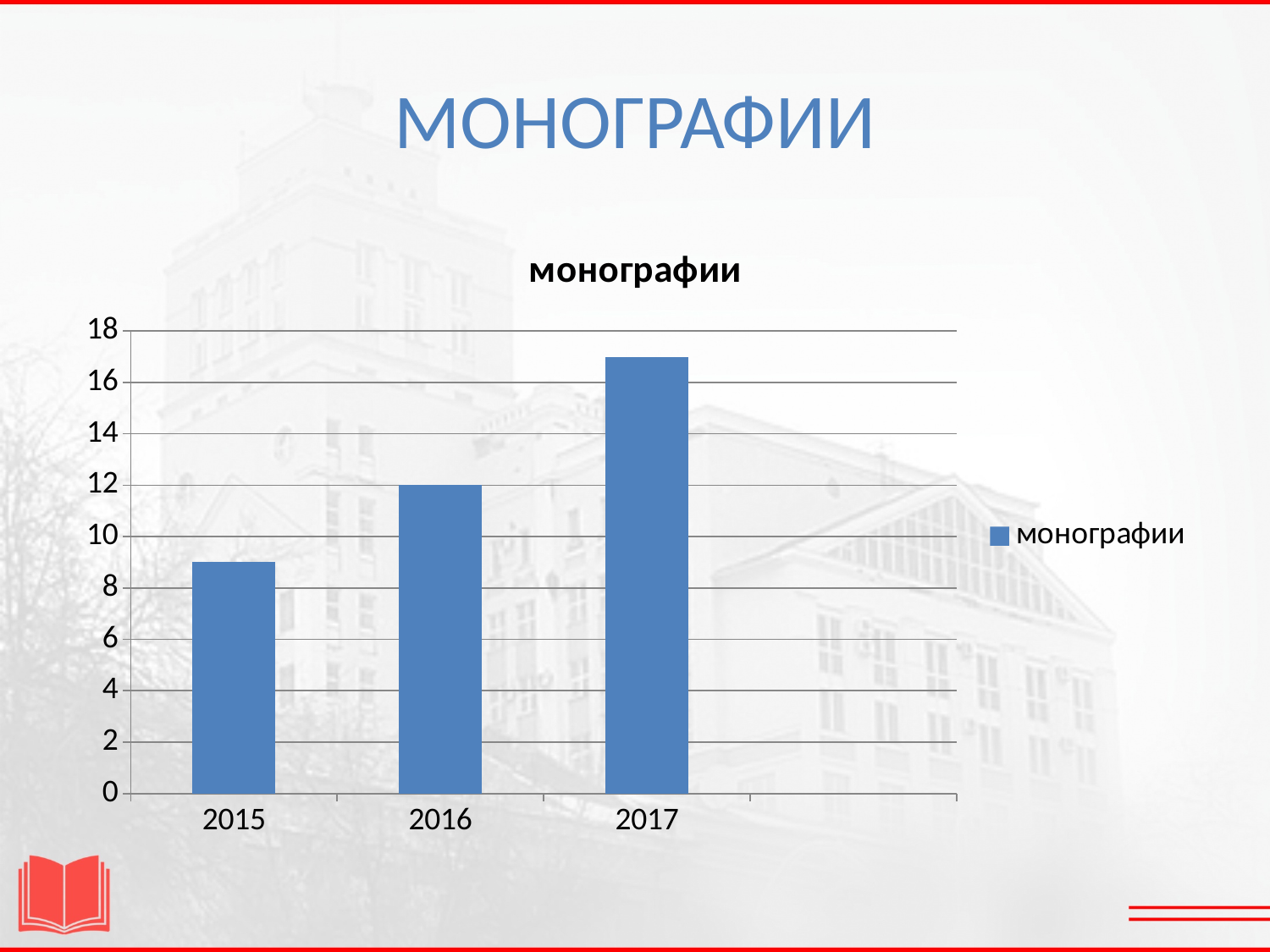
Which year has the lowest value? 2015 Is the value for 2015 greater or less than 8? greater How many years are shown on the x axis? 3 What kind of chart is shown? bar chart Is the value for 2015 greater or less than 10? less Which year has the highest value? 2017 Do the values rise or fall from 2015 to 2017? rise Which is larger, the value for 2015 or the value for 2016? 2016 Is the value for 2017 greater or less than 16? greater How many series does the legend list? 1 What is the value for 2016? 12